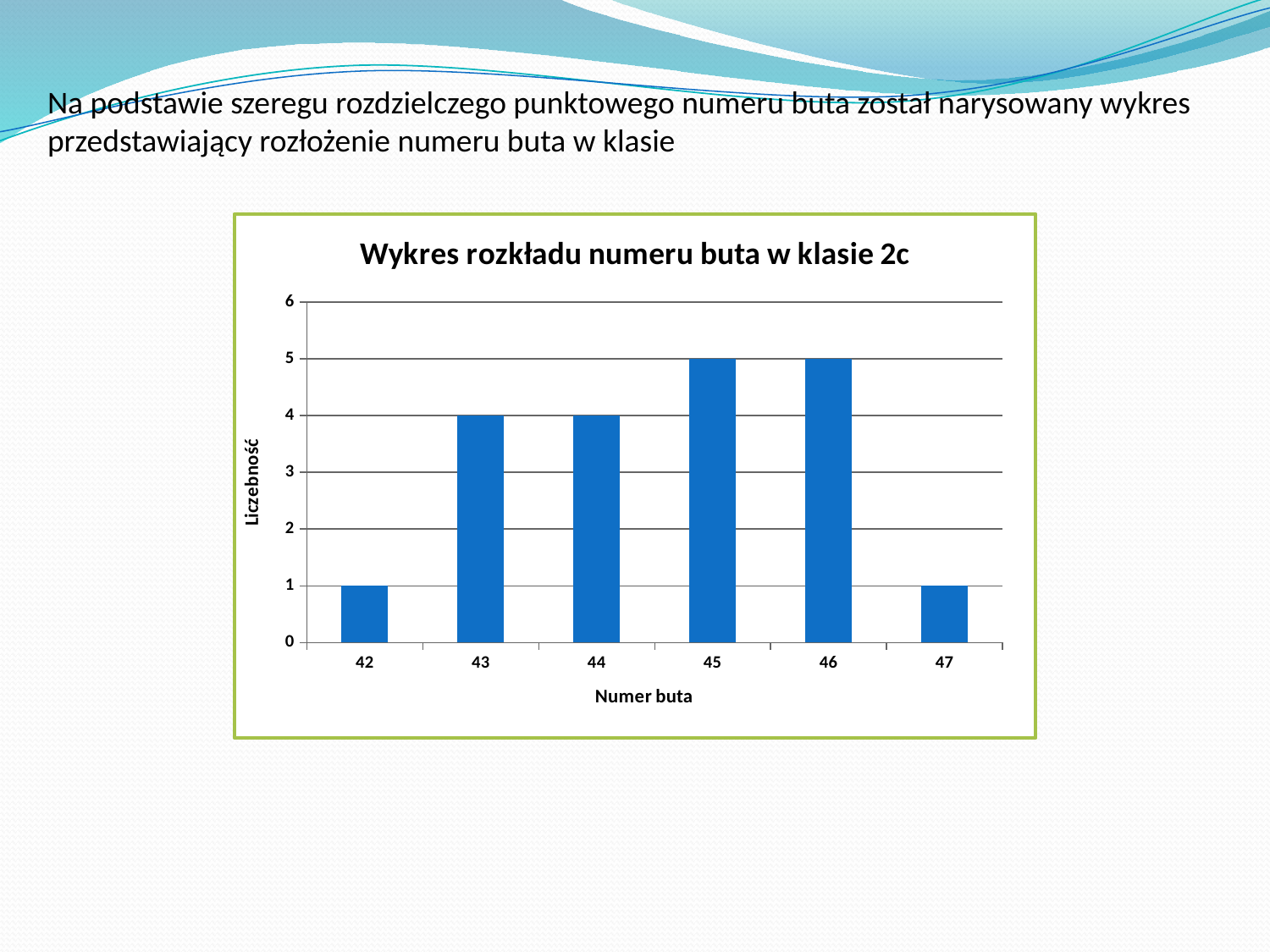
Which has a larger value, shoe size 43 or shoe size 45? 45 Which has a larger value, shoe size 44 or shoe size 47? 44 What is the value (Liczebność) for shoe size 45? 5 What is the title of the chart? Wykres rozkładu numeru buta w klasie 2c What type of chart is shown on the slide? bar chart What is the value (Liczebność) for shoe size 43? 4 What is the value (Liczebność) for shoe size 42? 1 Is the value for shoe size 44 greater or less than 3? greater How many shoe-size categories are shown on the x axis? 6 What is the difference between the values for shoe size 46 and shoe size 42? 4 What is the label of the x axis? Numer buta What is the value (Liczebność) for shoe size 47? 1